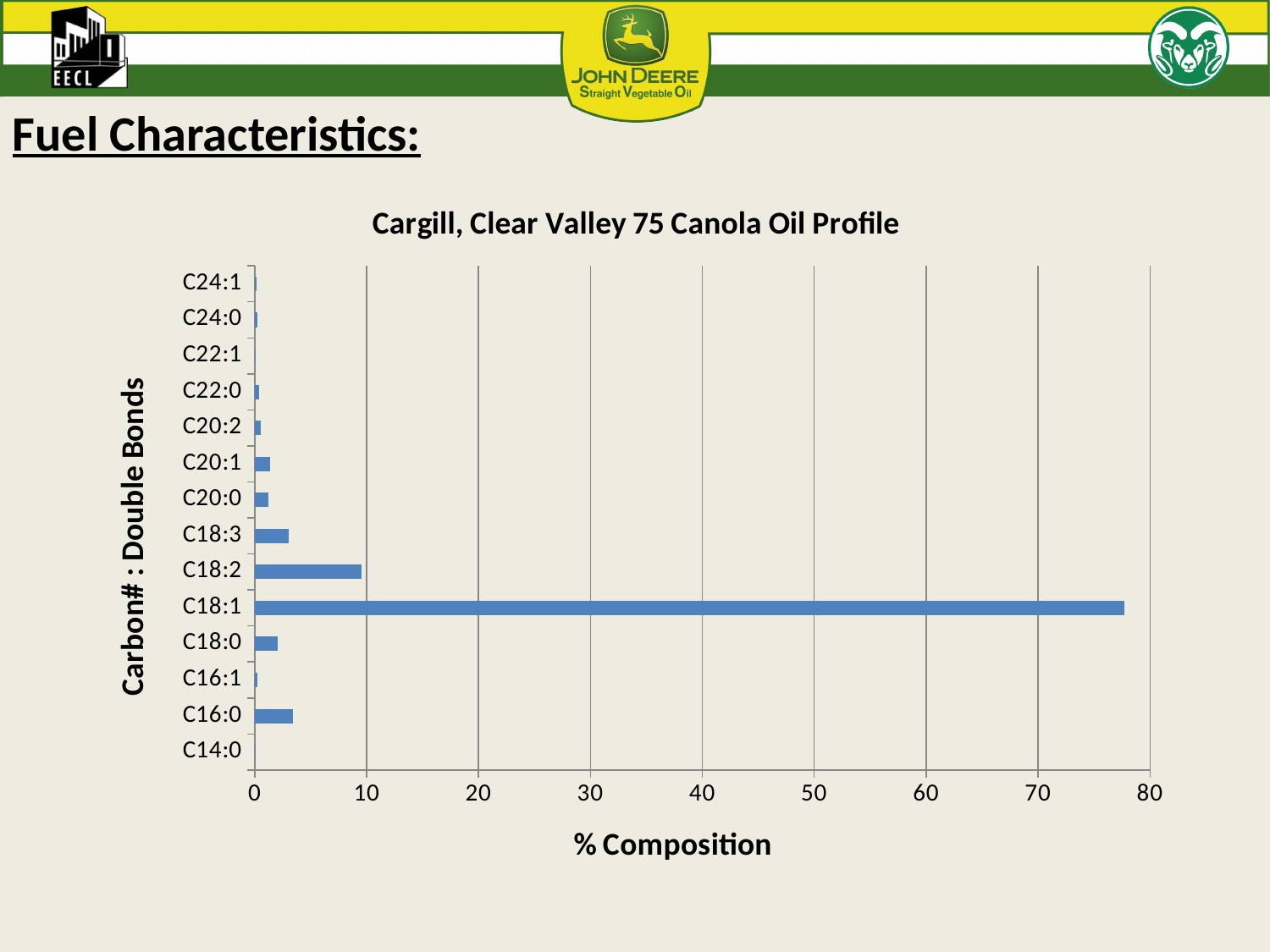
Is the value for C18:1 greater or less than 70? greater How many categories are listed on the vertical axis of the chart? 14 What type of chart is shown on the slide? bar chart Is the value for C16:0 greater or less than 10? less Is the value for C18:2 greater or less than 10? less Which has a larger % Composition, C18:2 or C18:3? C18:2 Which has a larger % Composition, C18:1 or C18:2? C18:1 What is the title of the chart? Cargill, Clear Valley 75 Canola Oil Profile Which category has the highest % Composition? C18:1 What is the label of the horizontal axis of the chart? % Composition Which has a larger % Composition, C16:0 or C18:0? C16:0